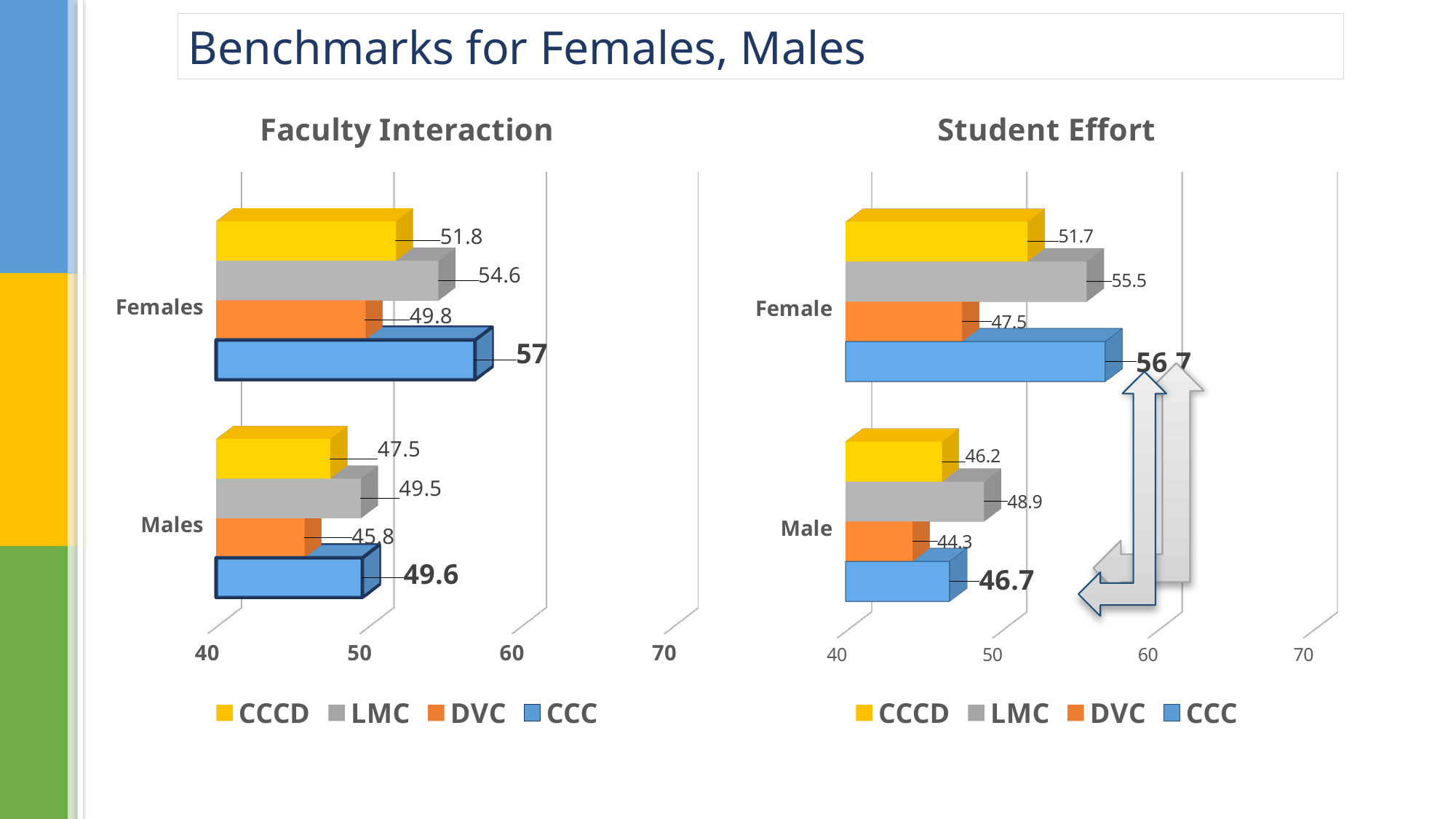
In the Student Effort chart, which series has the highest value for Male? LMC In the Faculty Interaction chart, what is the difference between the CCCD values for Females and Males? 4.3 In the Faculty Interaction chart, what is the value for CCC for Females? 57 How many series does the legend of the Student Effort chart list? 4 In the Student Effort chart, what is the value for DVC for Male? 44.3 In the Faculty Interaction chart, is the value for DVC for Males greater or less than 50? less What is the title of the chart on the right side of the slide? Student Effort In the Faculty Interaction chart, what is the value for LMC for Males? 49.5 What kind of chart is the Faculty Interaction chart? bar chart In the Student Effort chart, which is larger for Female: CCCD or LMC? LMC In the Faculty Interaction chart, which series has the lowest value for Males? DVC In the Student Effort chart, what is the value for LMC for Female? 55.5